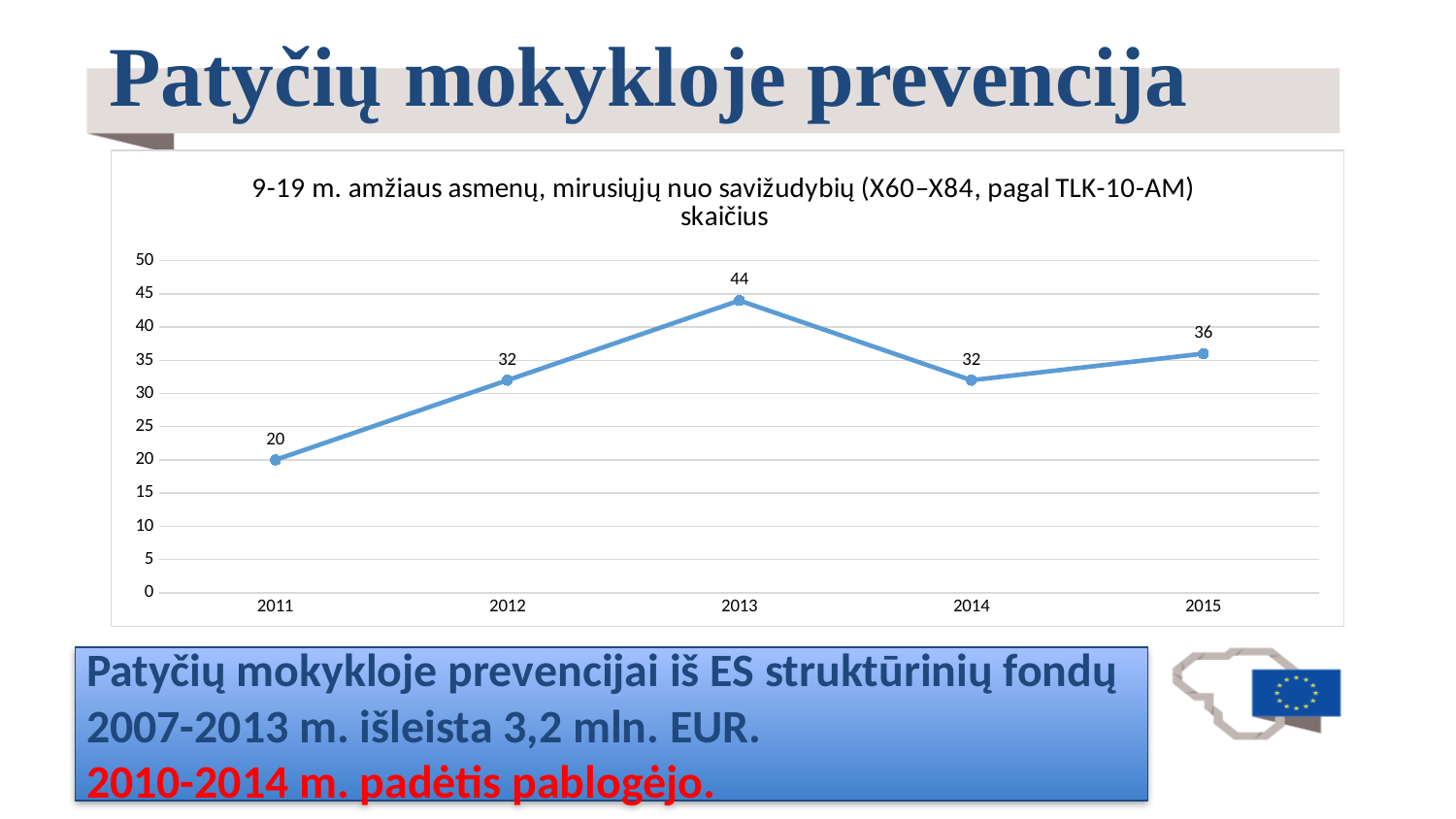
What is the value for 2011? 20 Does the value rise or fall from 2011 to 2013? Rise Which is larger, the value for 2012 or the value for 2015? 2015 How many data points are plotted on the chart? 5 Which year has the highest value? 2013 What is the difference between the values for 2015 and 2014? 4 What is the value for 2013? 44 What kind of chart is shown on the slide? Line chart Does the value rise or fall from 2013 to 2014? Fall What is the difference between the values for 2013 and 2011? 24 Which year has the lowest value? 2011 What is the value for 2015? 36